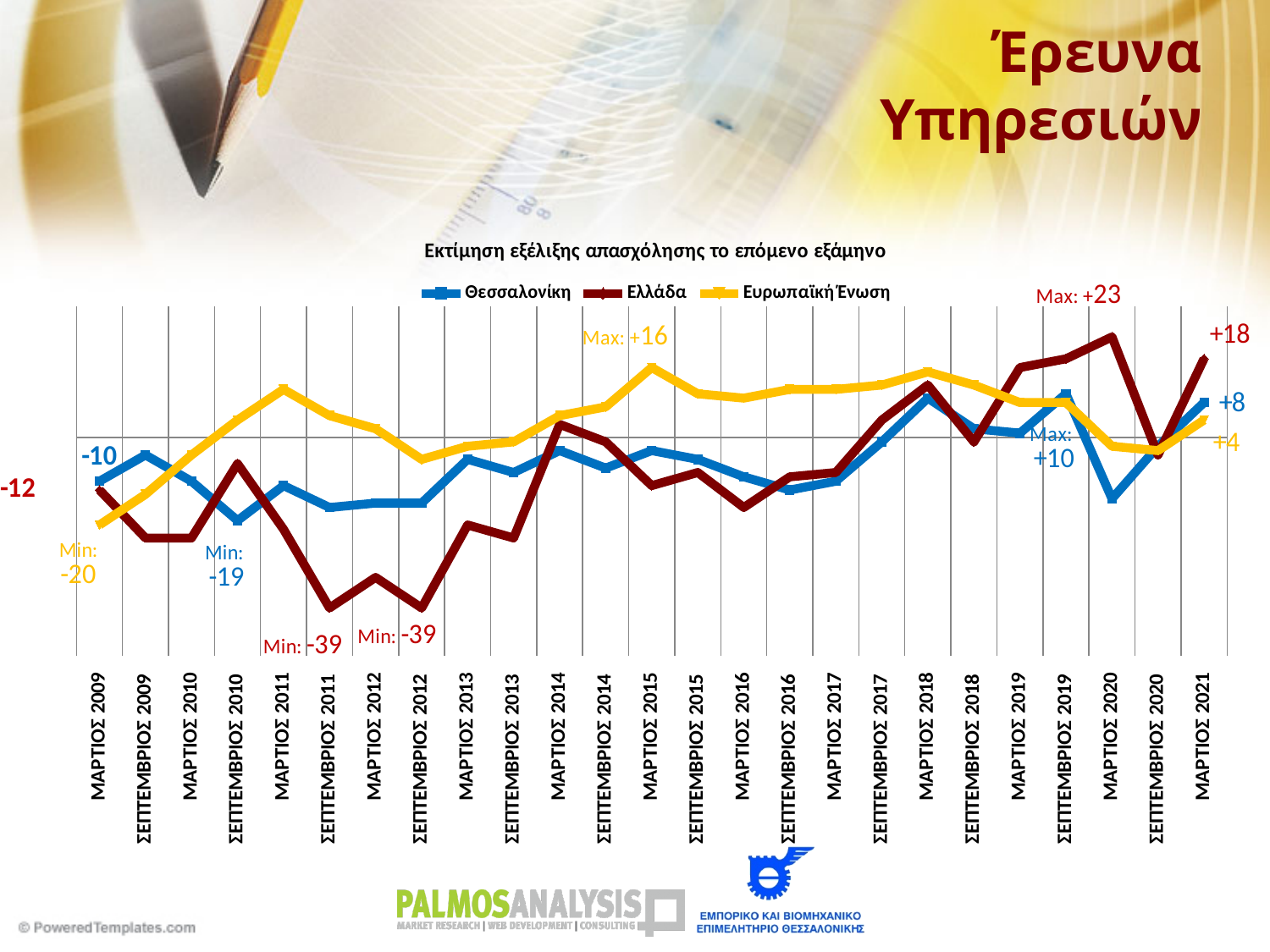
What is the minimum value reached by the Ευρωπαϊκή Ένωση series? -20 How many time points are shown on the x axis? 25 What is the value for Θεσσαλονίκη in ΜΑΡΤΙΟΣ 2009? -10 How many series does the legend list? 3 What kind of chart is shown on the slide? line chart What is the maximum value reached by the Ελλάδα series? +23 What is the title of the chart? Εκτίμηση εξέλιξης απασχόλησης το επόμενο εξάμηνο What is the difference between the Ελλάδα and Ευρωπαϊκή Ένωση values in ΜΑΡΤΙΟΣ 2021? 14 What is the value for Ευρωπαϊκή Ένωση in ΜΑΡΤΙΟΣ 2021? +4 Which series has the higher value in ΜΑΡΤΙΟΣ 2021, Θεσσαλονίκη or Ευρωπαϊκή Ένωση? Θεσσαλονίκη What is the value for Ελλάδα in ΜΑΡΤΙΟΣ 2021? +18 What is the value for Θεσσαλονίκη in ΜΑΡΤΙΟΣ 2021? +8